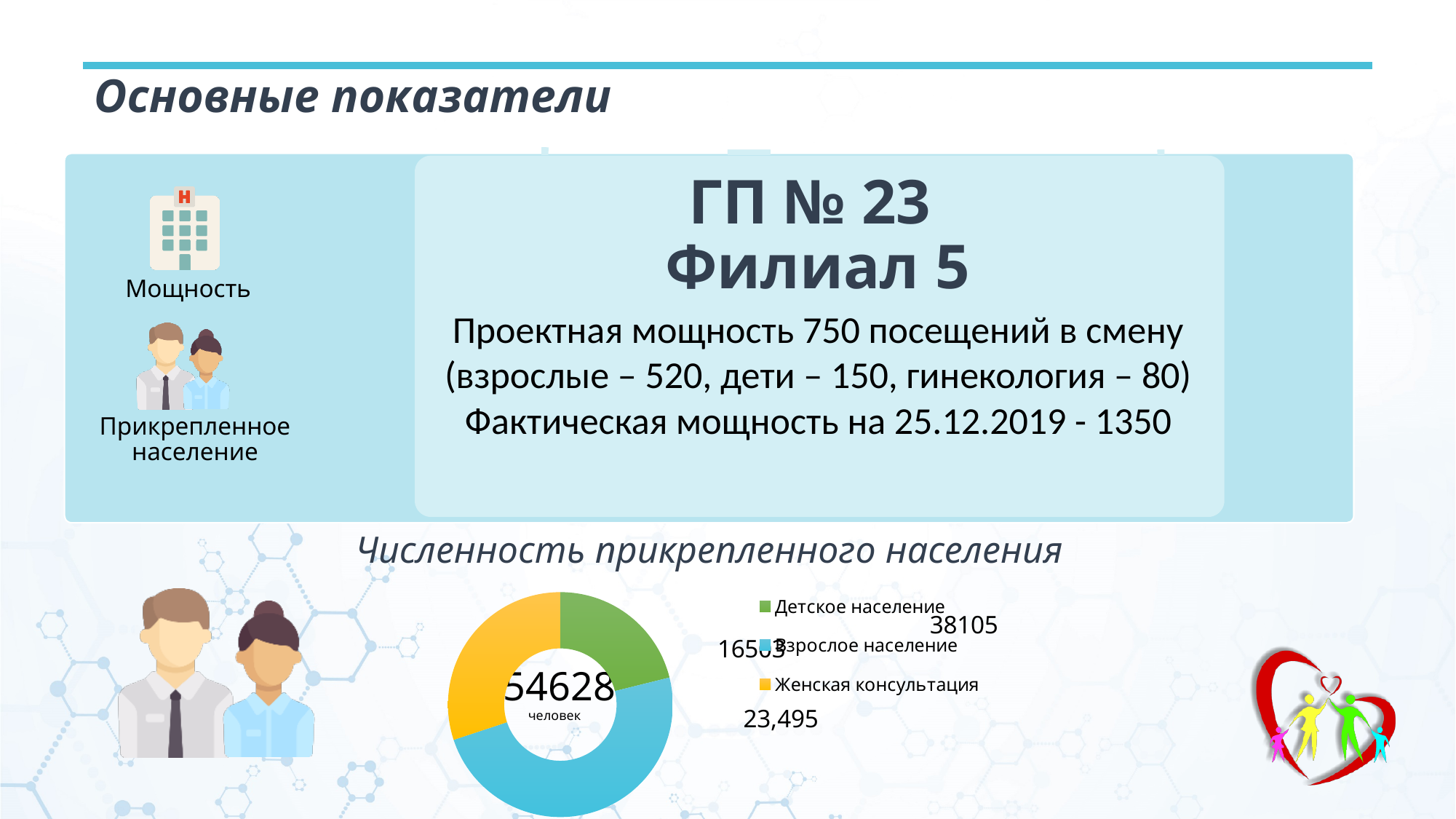
How many categories does the legend of the doughnut chart list? 3 Which legend entry of the doughnut chart is shown in green? Детское население What unit label is printed under the number in the centre of the doughnut chart? человек What colour represents Женская консультация in the doughnut chart? Yellow What number is printed in the centre of the doughnut chart? 54628 Which category has the largest slice in the doughnut chart? Взрослое население In the doughnut chart, which slice is larger: Взрослое население or Детское население? Взрослое население In the doughnut chart, which slice is larger: Взрослое население or Женская консультация? Взрослое население What kind of chart is shown under the heading "Численность прикрепленного населения"? Doughnut (pie) chart